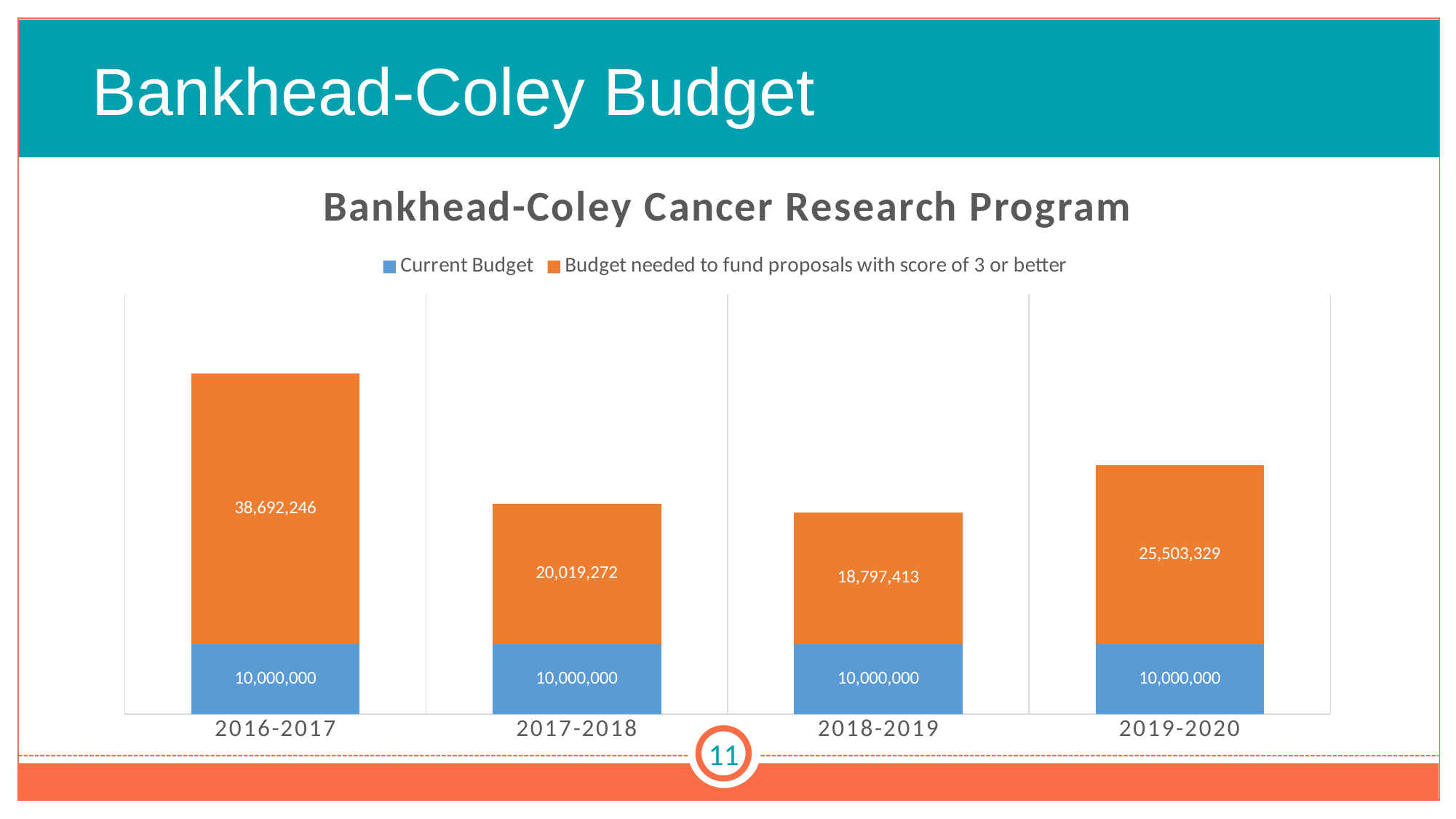
What is the difference between the 'Budget needed to fund proposals with score of 3 or better' for 2016-2017 and 2017-2018? 18,672,974 What is the 'Current Budget' value for 2018-2019? 10,000,000 What is the title of the chart? Bankhead-Coley Cancer Research Program What is the total of the stacked bar for 2017-2018? 30,019,272 What is the value of 'Budget needed to fund proposals with score of 3 or better' for 2019-2020? 25,503,329 What is the value of 'Budget needed to fund proposals with score of 3 or better' for 2016-2017? 38,692,246 Is the 'Budget needed to fund proposals with score of 3 or better' larger for 2019-2020 or for 2018-2019? 2019-2020 What kind of chart is shown on the slide? Stacked bar chart Which year has the lowest 'Budget needed to fund proposals with score of 3 or better'? 2018-2019 How many years are shown on the x axis? 4 Which year has the highest 'Budget needed to fund proposals with score of 3 or better'? 2016-2017 How many series does the legend list? 2